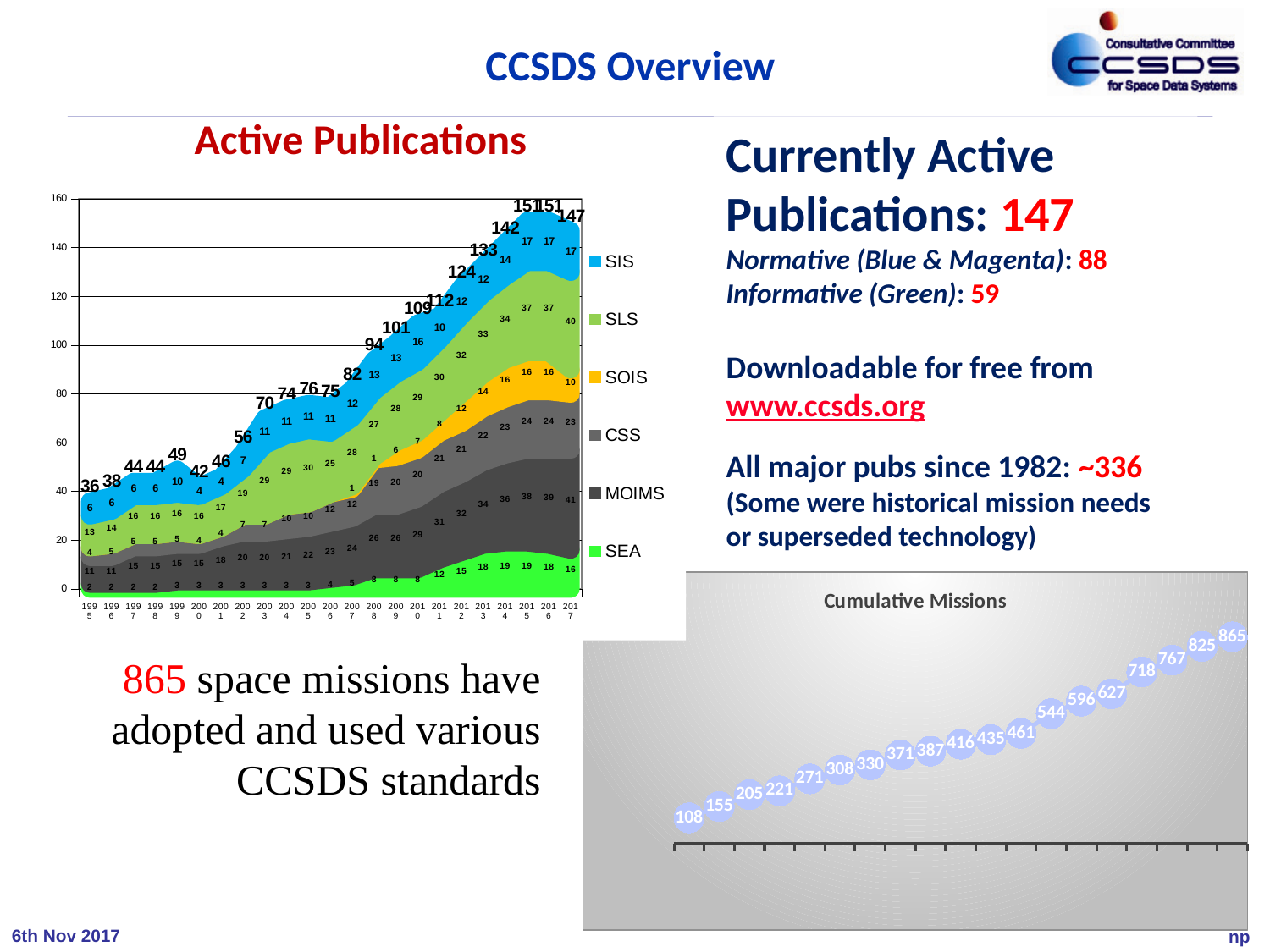
In the Cumulative Missions chart, what is the first (lowest) value shown? 108 In the Active Publications chart, what is the total number of active publications in 2008? 94 In the Active Publications chart, what is the difference between the totals for 2017 and 2012? 23 In the Active Publications chart, what is the total number of active publications in 2017? 147 What kind of chart is the Active Publications chart? Stacked area chart In the Active Publications chart, what is the SEA value for 2017? 16 How many series does the legend of the Active Publications chart list? 6 How many data points are plotted in the Cumulative Missions chart? 19 In the Active Publications chart, which year has the larger total, 2003 or 2004? 2004 In the Active Publications chart, which year has the lowest total of active publications? 1995 In the Cumulative Missions chart, do the values rise or fall from left to right? Rise In the Cumulative Missions chart, what is the highest value shown? 865